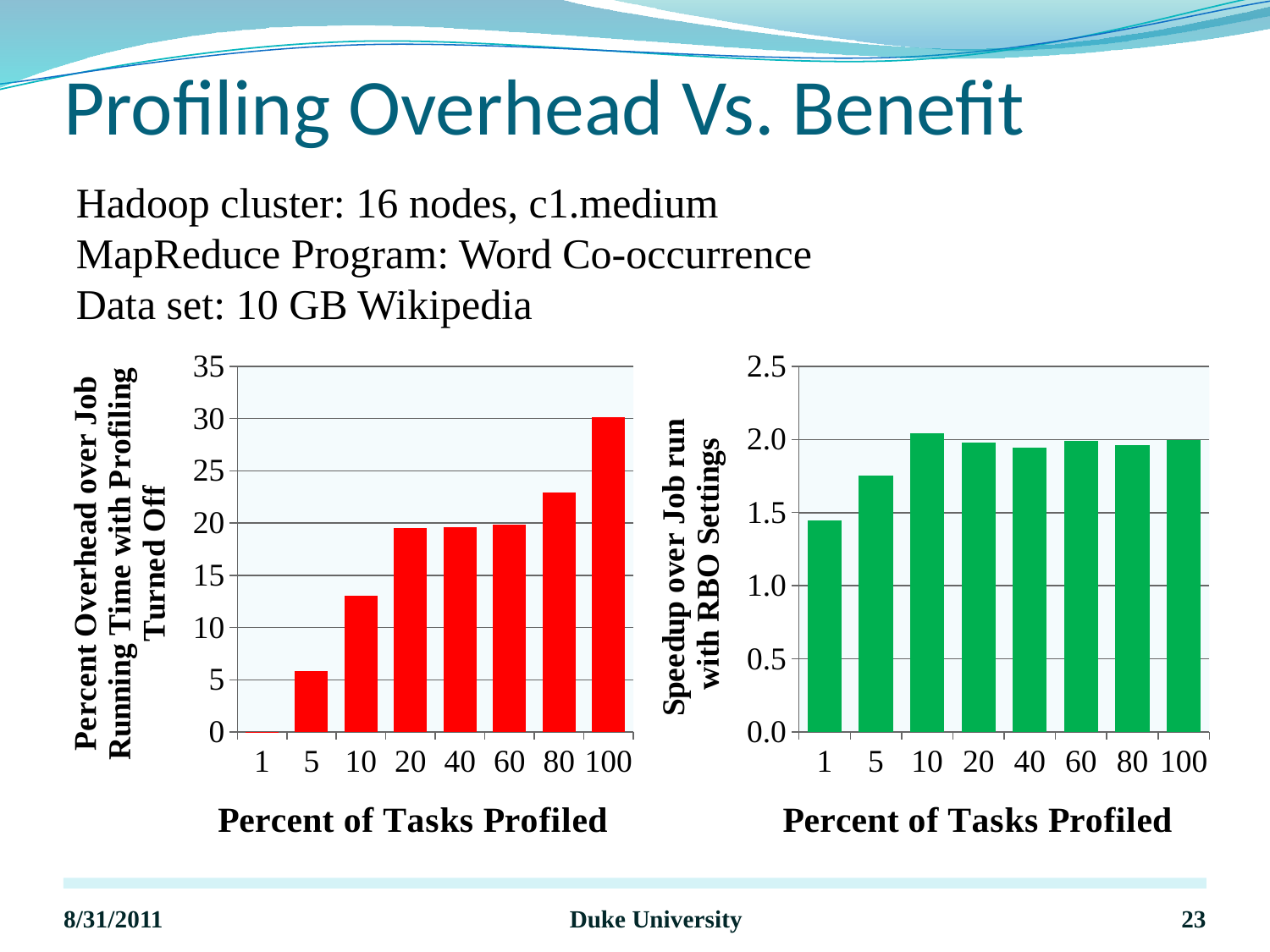
On the left chart (Percent Overhead), which percent of tasks profiled has the lowest overhead? 1 On the left chart (Percent Overhead), which is larger, the value for 80 or the value for 100? 100 On the right chart (Speedup over Job run with RBO Settings), is the value for 5 percent of tasks profiled greater or less than 1.5? greater On the left chart (Percent Overhead), how many percent-of-tasks-profiled categories are shown on the x axis? 8 On the right chart (Speedup over Job run with RBO Settings), which percent of tasks profiled has the lowest speedup? 1 What kind of chart is the right chart (Speedup over Job run with RBO Settings)? bar chart On the left chart (Percent Overhead), is the value for 5 percent of tasks profiled greater or less than 10? less On the right chart (Speedup over Job run with RBO Settings), is the value for 1 percent of tasks profiled greater or less than 1.5? less On the left chart (Percent Overhead), which percent of tasks profiled has the highest overhead? 100 On the left chart (Percent Overhead), do the values generally rise or fall as the percent of tasks profiled increases? rise On the right chart (Speedup over Job run with RBO Settings), which is larger, the value for 1 or the value for 100? 100